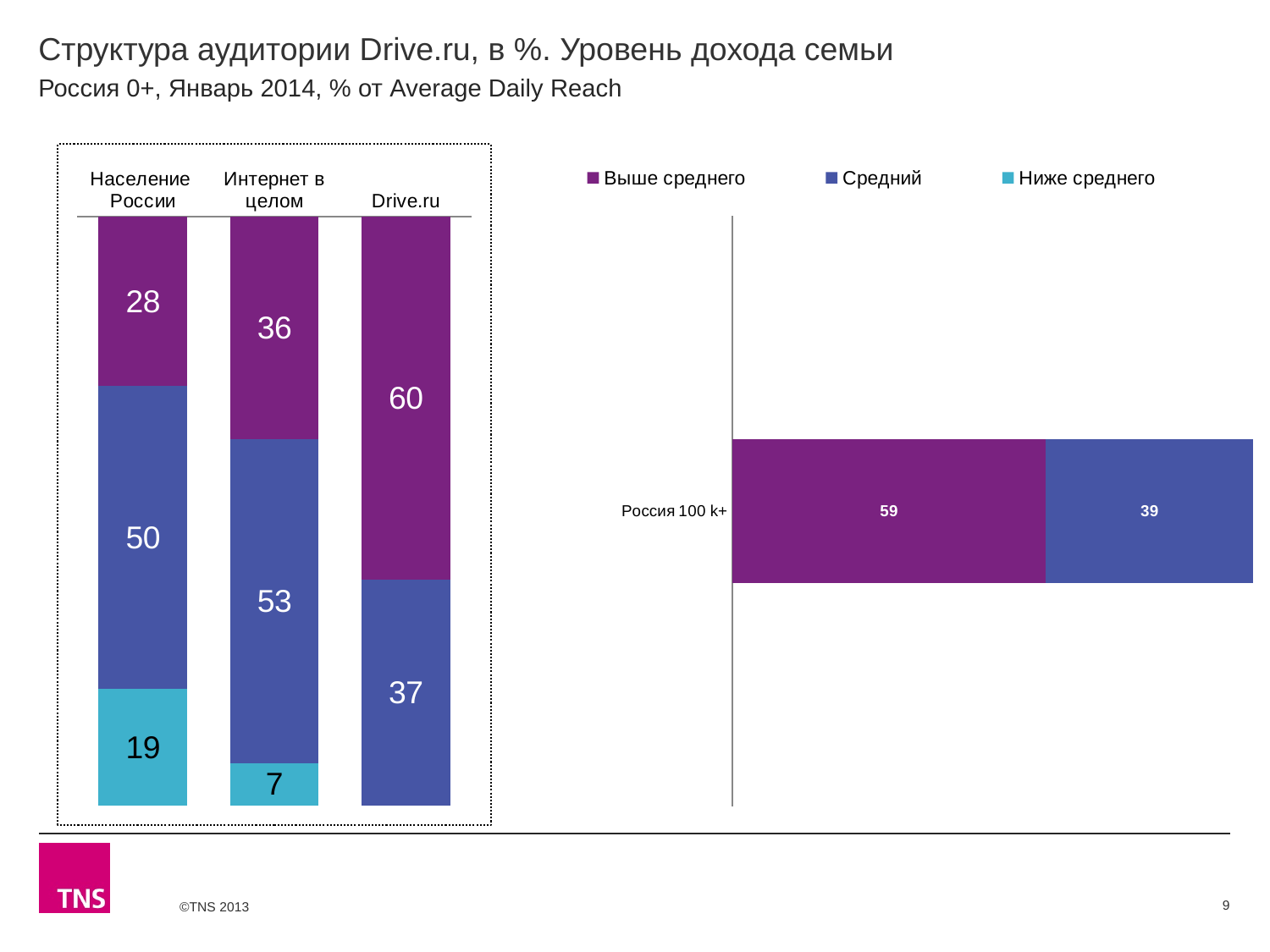
In the left chart, what is the value of the 'Ниже среднего' segment for 'Население России'? 19 In the left chart, what is the value of the 'Выше среднего' segment for Drive.ru? 60 How many series does the legend list? 3 In the left chart, which category has the lowest 'Ниже среднего' value among those with a labelled segment? Интернет в целом In the right chart, what is the value of the 'Средний' segment for 'Россия 100 k+'? 39 In the right chart, what is the difference between the 'Выше среднего' and 'Средний' values for 'Россия 100 k+'? 20 In the left chart, what is the value of the 'Средний' segment for 'Интернет в целом'? 53 How many categories are shown on the x axis of the left chart? 3 In the left chart, which is larger: the 'Средний' value for 'Население России' or for Drive.ru? Население России In the left chart, what is the difference between the 'Выше среднего' values for Drive.ru and 'Население России'? 32 In the left chart, which category has the highest 'Выше среднего' value? Drive.ru What kind of chart is the right chart? Stacked bar chart